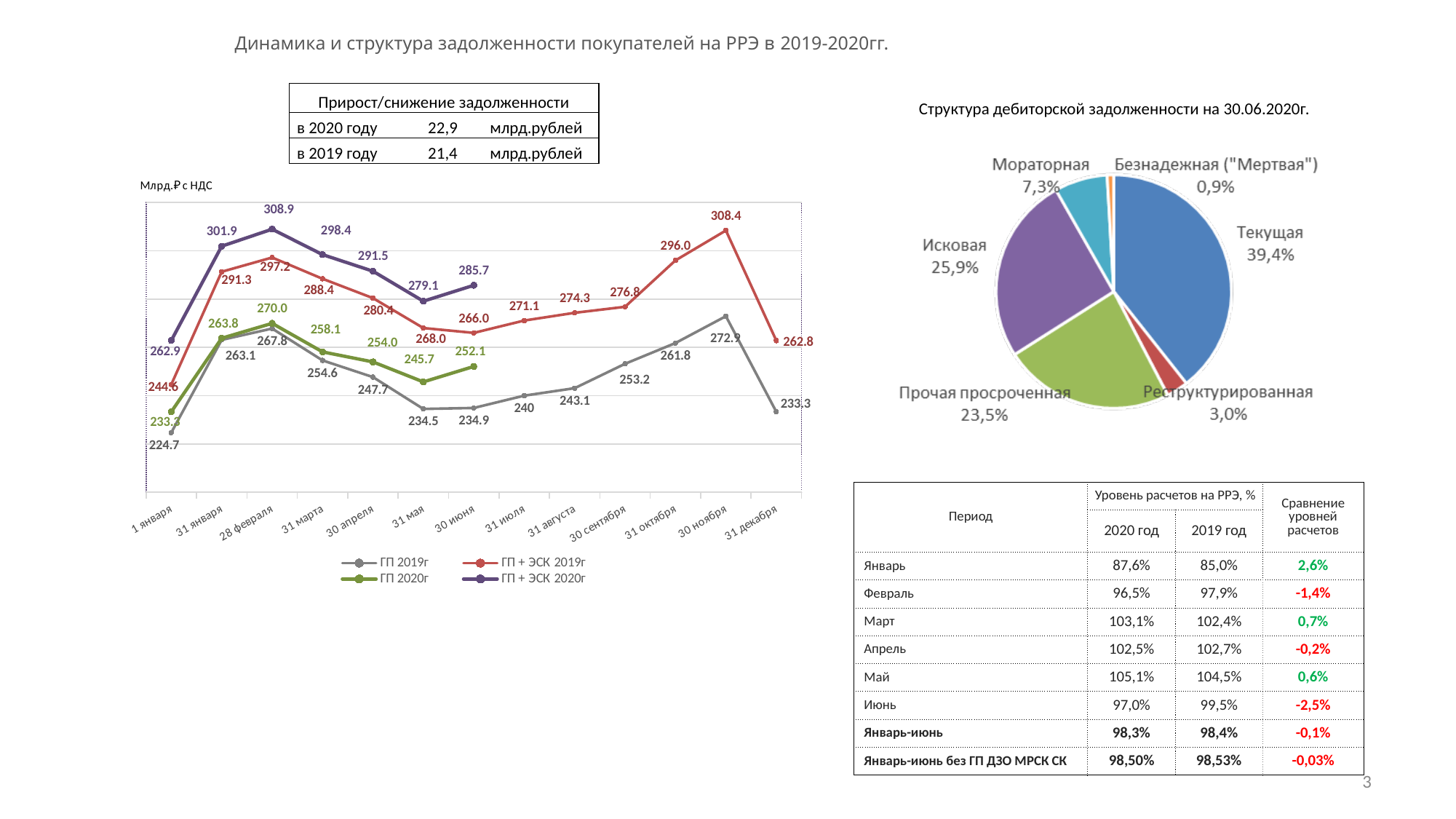
On the pie chart 'Структура дебиторской задолженности на 30.06.2020г.', what share does Исковая have? 25,9% On the line chart, at which date is the ГП 2019г series lowest? 1 января How many series does the legend of the line chart list? 4 On the pie chart 'Структура дебиторской задолженности на 30.06.2020г.', which category has the largest share? Текущая On the line chart, what is the value of the ГП 2019г series on 1 января? 224.7 How many dates are shown on the x axis of the line chart? 13 On the line chart, what is the difference between the ГП + ЭСК 2020г and ГП 2020г values on 31 мая? 33.4 On the line chart, at which date does the ГП + ЭСК 2019г series reach its highest value? 30 ноября On the line chart, does the ГП + ЭСК 2020г series rise or fall from 28 февраля to 31 мая? fall On the line chart, which is larger on 31 марта: ГП 2020г or ГП 2019г? ГП 2020г On the line chart, what is the value of the ГП 2020г series on 30 июня? 252.1 On the line chart, what is the value of the ГП + ЭСК 2020г series on 28 февраля? 308.9